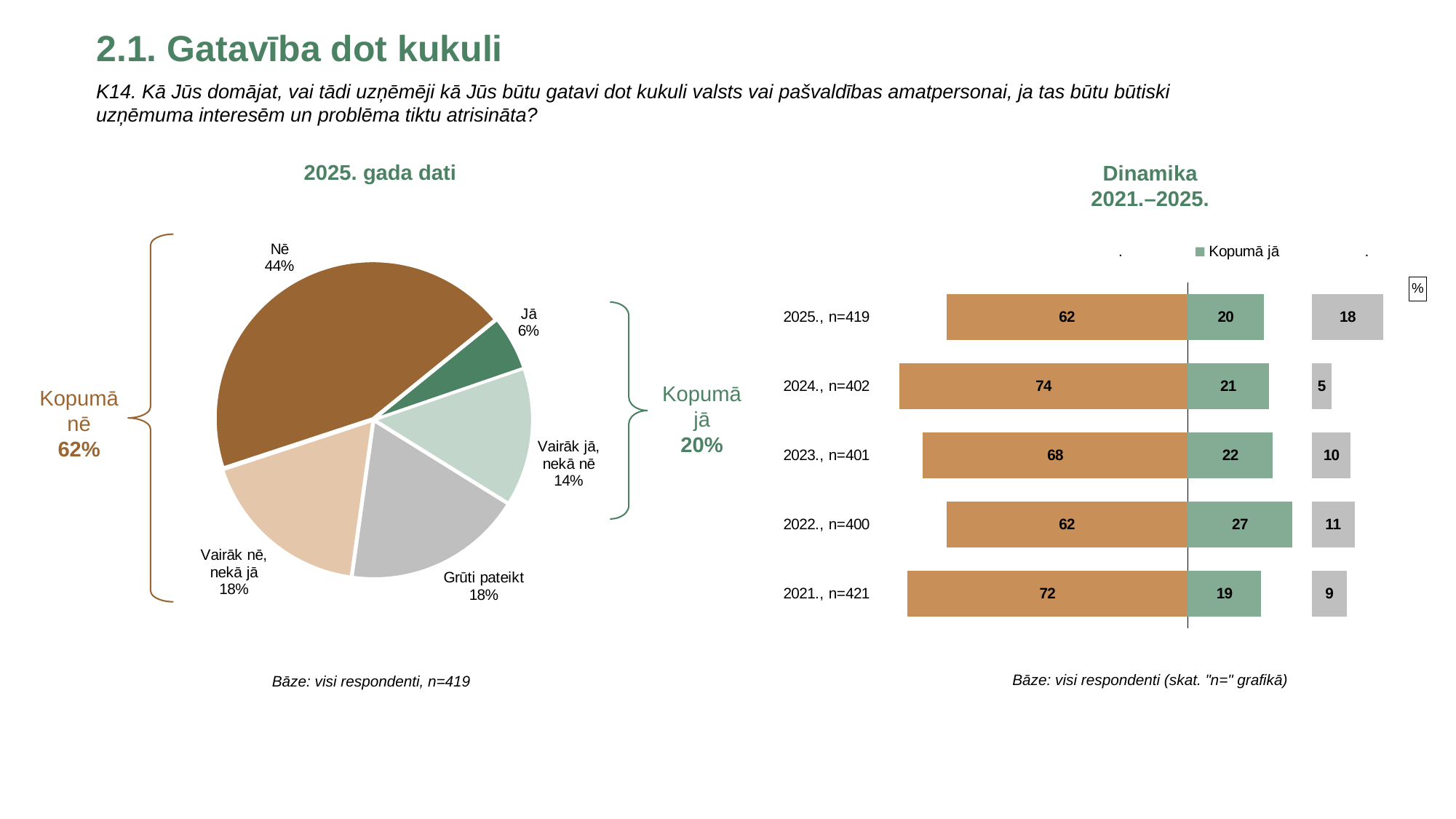
In the pie chart '2025. gada dati', what percentage is shown for 'Nē'? 44% In the pie chart '2025. gada dati', which slice is the largest? Nē In the pie chart '2025. gada dati', how many slices does the pie have? 5 In the 'Dinamika 2021.–2025.' chart, which year has the highest 'Kopumā jā' value? 2022 In the 'Dinamika 2021.–2025.' chart, what is the 'Kopumā jā' value for 2025? 20 In the pie chart '2025. gada dati', what percentage is shown for 'Jā'? 6% In the 'Dinamika 2021.–2025.' chart, is the grey value for 2025 larger or smaller than the grey value for 2024? larger In the pie chart '2025. gada dati', which slice is the smallest? Jā In the pie chart '2025. gada dati', what is the difference in percentage points between 'Nē' and 'Vairāk jā, nekā nē'? 30 In the pie chart '2025. gada dati', what is the 'Kopumā nē' total shown beside the pie? 62% In the 'Dinamika 2021.–2025.' chart, what is the value of the orange bar for 2024? 74 What kind of chart is the 'Dinamika 2021.–2025.' chart? bar chart